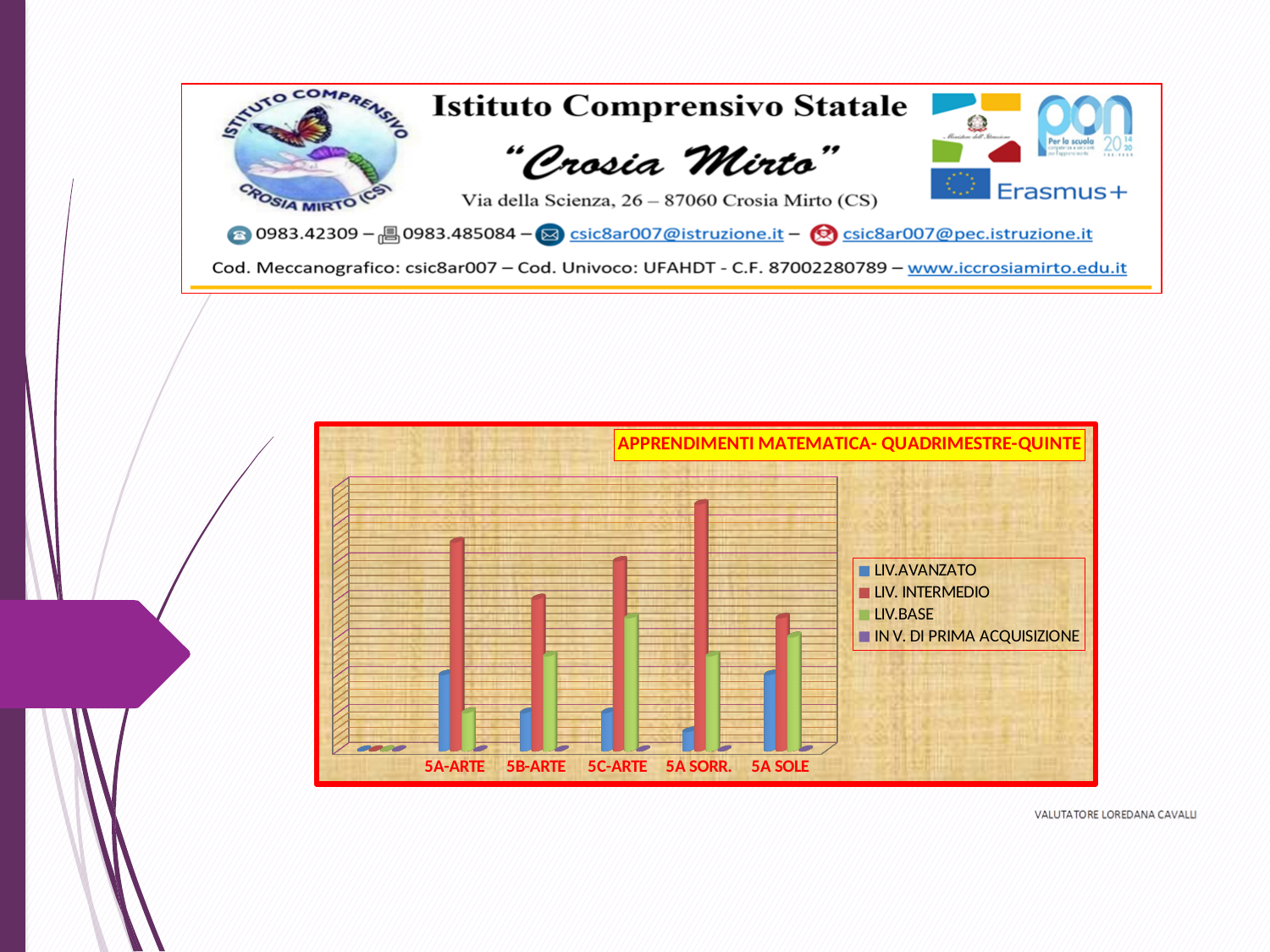
Which class has the highest LIV. INTERMEDIO bar? 5A SORR. Which series has the tallest bar in every class shown? LIV. INTERMEDIO What is the title of the chart? APPRENDIMENTI MATEMATICA- QUADRIMESTRE-QUINTE For 5A-ARTE, which is larger: LIV.AVANZATO or LIV. INTERMEDIO? LIV. INTERMEDIO How many series does the chart legend list? 4 Which class has the lowest LIV.BASE bar? 5A-ARTE How many classes (categories) are shown on the x axis of the chart? 5 Which series is shown in red in the chart? LIV. INTERMEDIO Which class has the lowest LIV.AVANZATO bar? 5A SORR. Which class has the lowest LIV. INTERMEDIO bar? 5A SOLE For 5A SOLE, which is larger: LIV.AVANZATO or LIV.BASE? LIV.BASE What kind of chart is shown on the slide? Bar chart